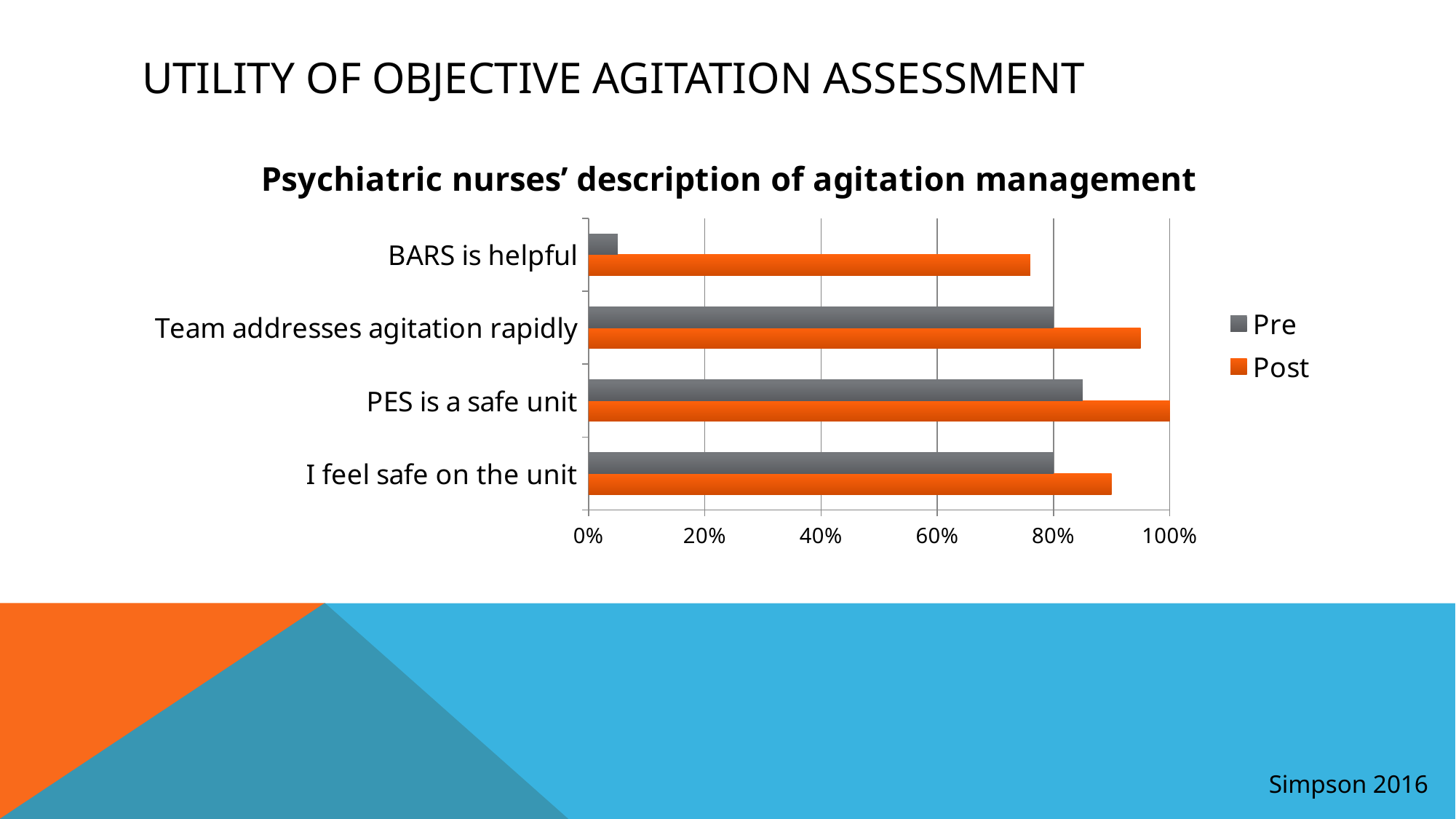
What is the Pre value for "Team addresses agitation rapidly"? 80% Is the Post value for "Team addresses agitation rapidly" greater or less than 80%? greater How many categories are shown on the chart? 4 Which category has the lowest Pre value? BARS is helpful For "I feel safe on the unit", which is larger, the Pre value or the Post value? Post What is the Post value for "PES is a safe unit"? 100% Which category has the highest Post value? PES is a safe unit What is the title of the chart? Psychiatric nurses' description of agitation management How many series does the legend list? 2 What kind of chart is shown on the slide? bar chart Is the Post value for "BARS is helpful" greater or less than 60%? greater Is the Pre value for "BARS is helpful" greater or less than 20%? less